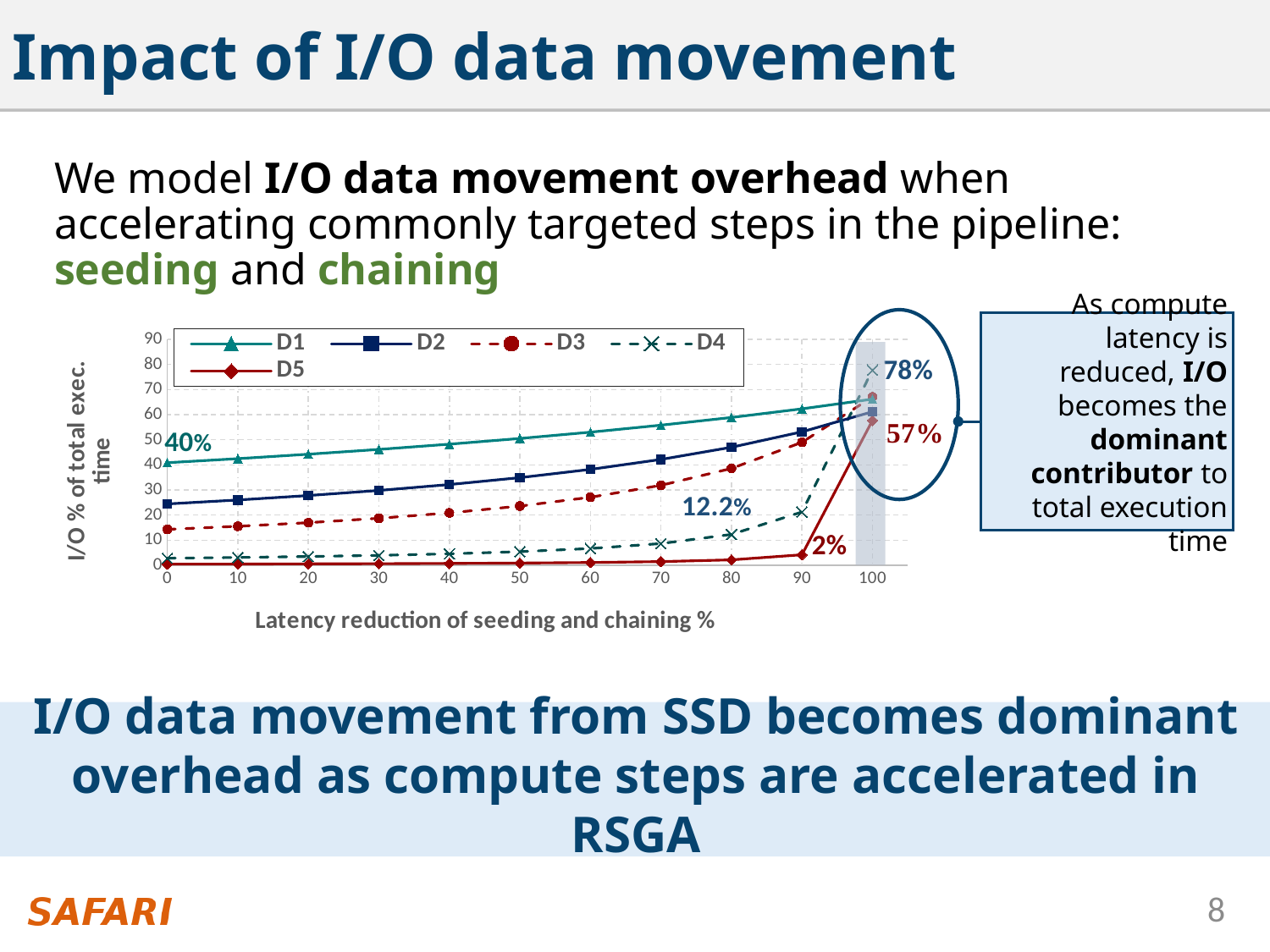
At 0% latency reduction, which series has the larger value, D1 or D2? D1 What is the I/O % of total execution time for D1 at 0% latency reduction? 40% How many series does the chart legend list? 5 Which series has the lowest I/O % of total execution time at 0% latency reduction? D5 What is the I/O % of total execution time for D4 at 100% latency reduction? 78% What is the title of the x axis of the chart? Latency reduction of seeding and chaining % How many tick points are shown along the x axis of the chart? 11 Does the D1 series rise or fall as latency reduction increases along the x axis? rise Is the value for D2 at 0% latency reduction greater or less than 30? less What is the I/O % of total execution time for D5 at 100% latency reduction? 57% Which series has the highest I/O % of total execution time at 100% latency reduction? D4 What kind of chart is shown on the slide? line chart